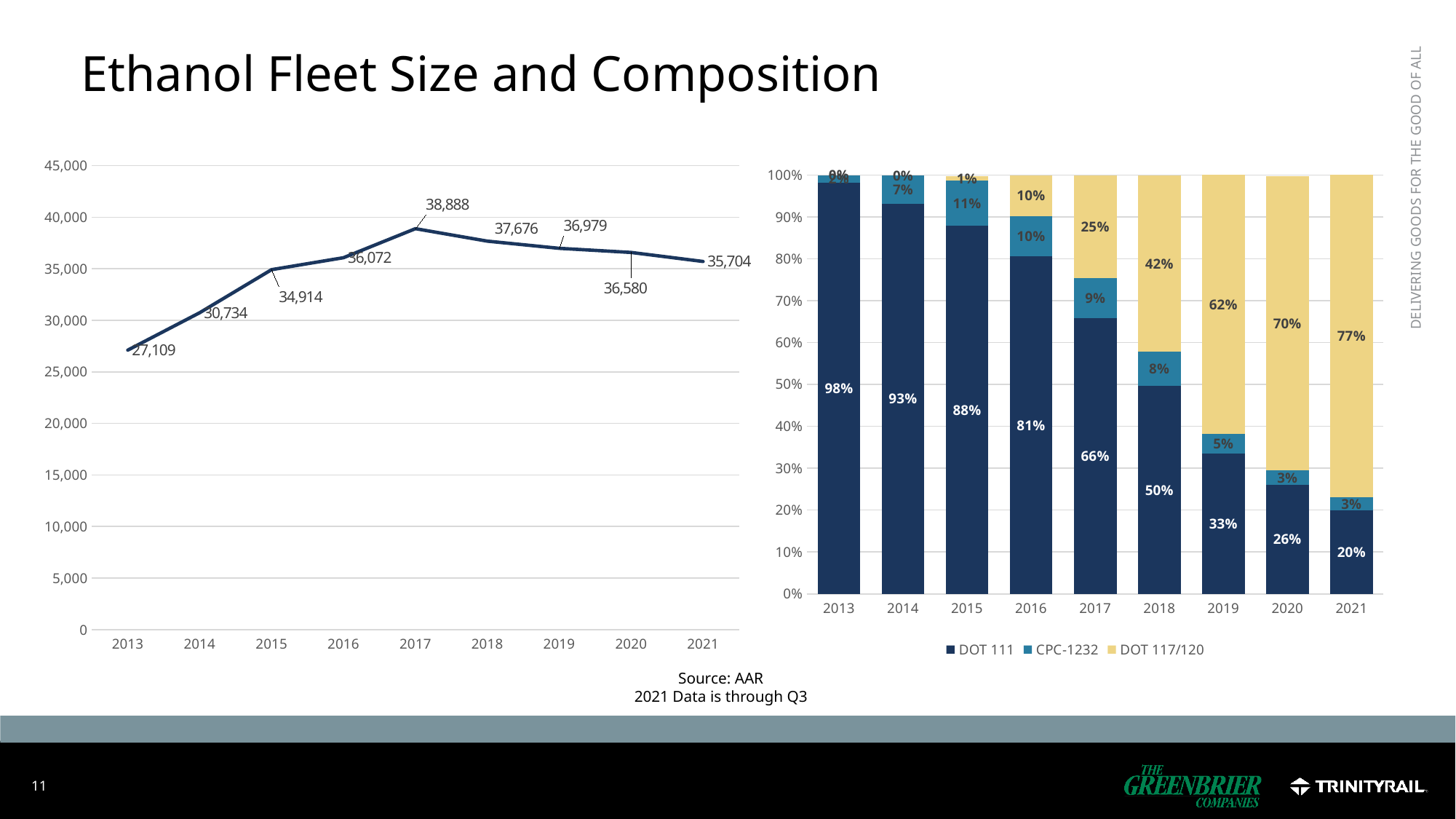
On the left chart, which year has the lowest value? 2013 On the right chart, does the DOT 111 share rise or fall from 2013 to 2021? fall On the left chart, which year has the highest value? 2017 On the left chart, what is the value for 2017? 38,888 On the left chart, what kind of chart is shown? line chart On the right chart, how many series does the legend list? 3 On the right chart, what is the DOT 111 share for 2016? 81% On the left chart, what is the value for 2013? 27,109 On the right chart, what is the DOT 117/120 share for 2019? 62% On the left chart, what is the difference between the values for 2017 and 2021? 3,184 On the right chart, what is the CPC-1232 share for 2015? 11% On the left chart, how many years are plotted on the x axis? 9